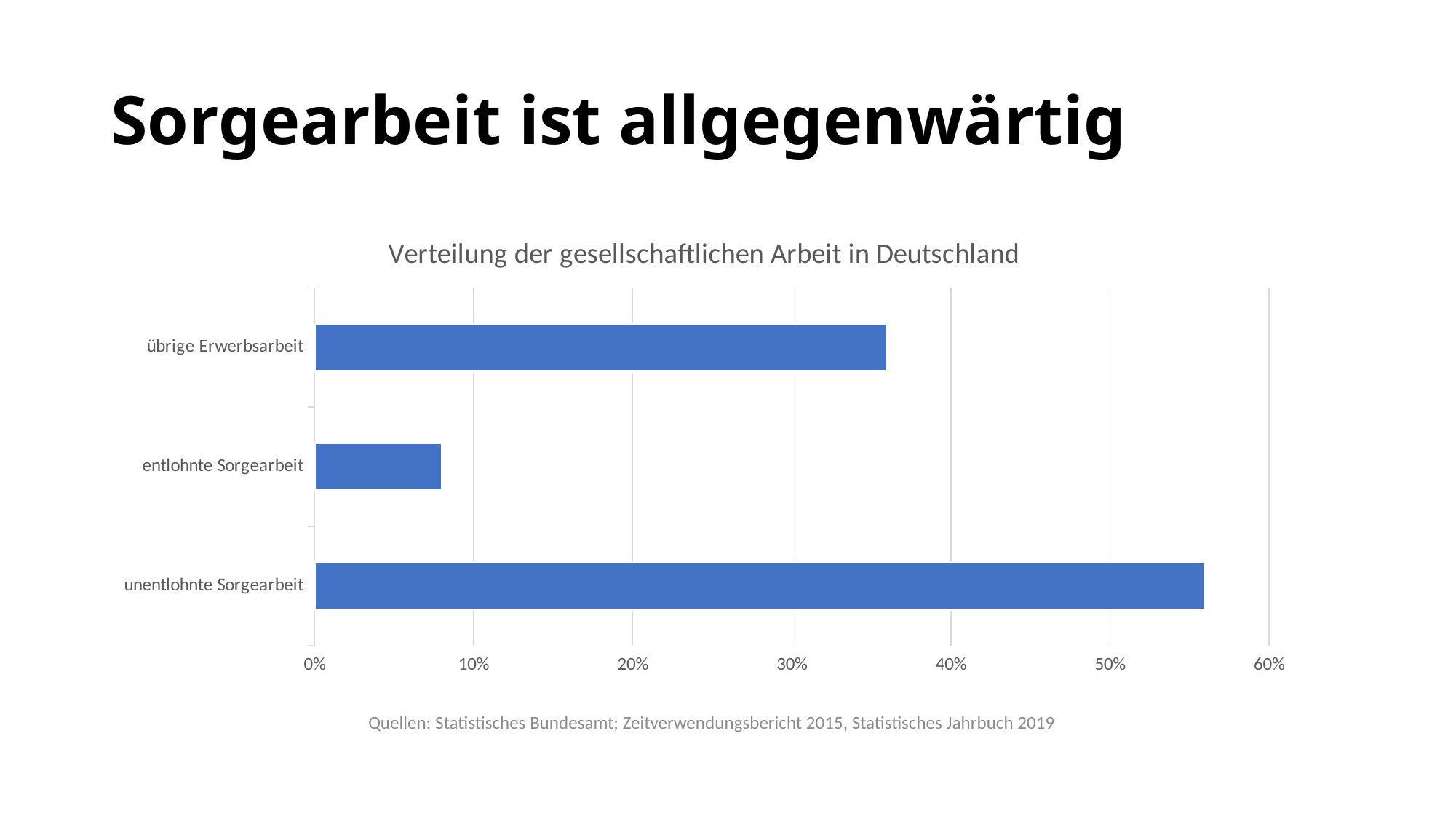
What is the highest value shown on the x axis? 60% How many categories does the chart show? 3 Which category has the lowest value? entlohnte Sorgearbeit Is the value for unentlohnte Sorgearbeit greater or less than 50%? greater Is the value for übrige Erwerbsarbeit greater or less than 40%? less What is the title of the chart? Verteilung der gesellschaftlichen Arbeit in Deutschland Is the value for übrige Erwerbsarbeit greater or less than 30%? greater What kind of chart is shown on the slide? bar chart Which is larger, the value for unentlohnte Sorgearbeit or the value for übrige Erwerbsarbeit? unentlohnte Sorgearbeit Which is larger, the value for übrige Erwerbsarbeit or the value for entlohnte Sorgearbeit? übrige Erwerbsarbeit Which category has the highest value? unentlohnte Sorgearbeit